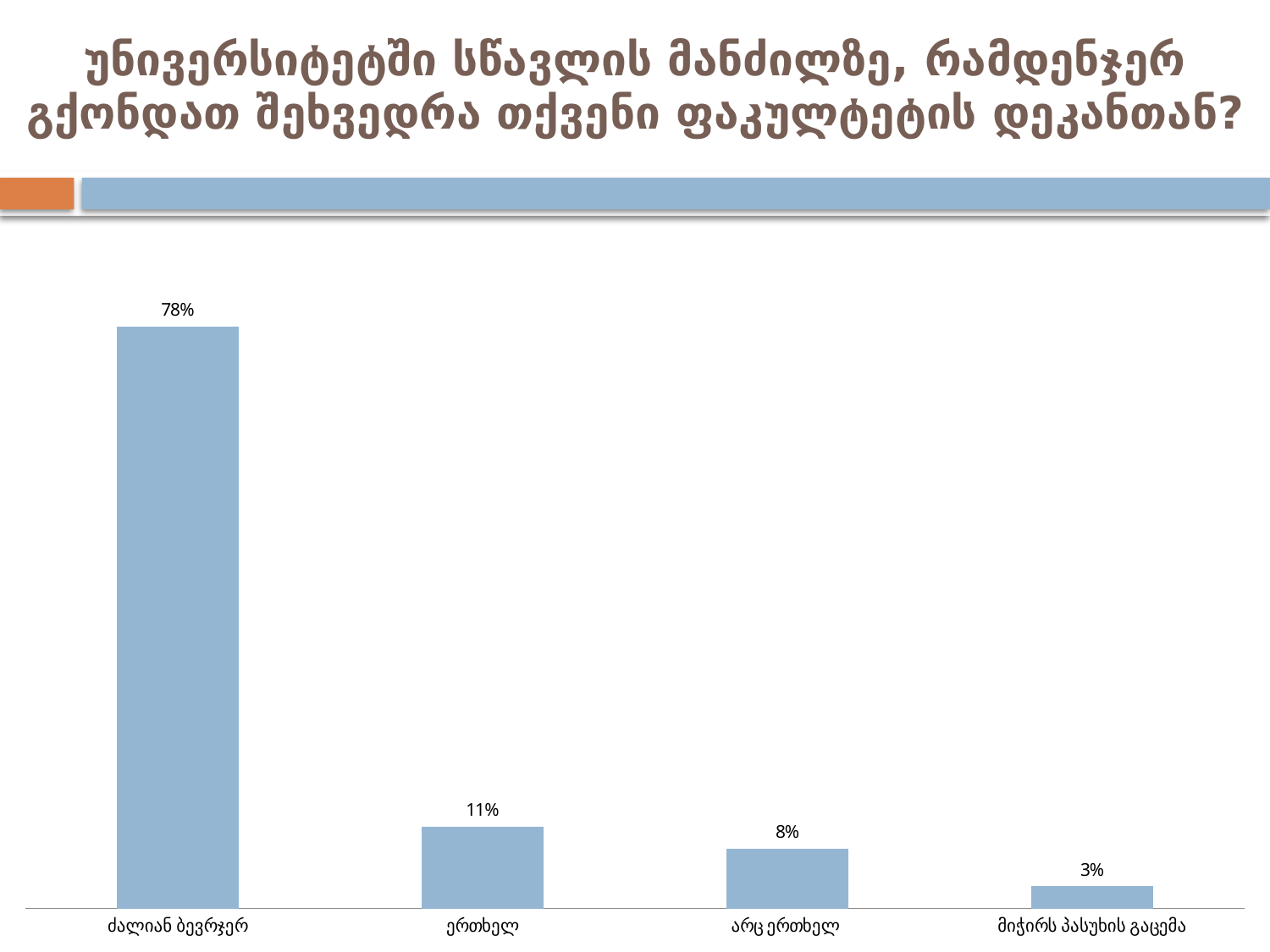
What value is shown for ძალიან ბევრჯერ? 78% What is the difference between the values for ერთხელ and არც ერთხელ? 3% Do the values rise or fall from left to right across the categories? Fall What kind of chart is shown on the slide? Bar chart Which category has the lowest value? მიჭირს პასუხის გაცემა What value is shown for მიჭირს პასუხის გაცემა? 3% How many categories are shown in the chart? 4 What is the difference between the values for ძალიან ბევრჯერ and ერთხელ? 67% What value is shown for არც ერთხელ? 8% Which is larger, the value for არც ერთხელ or the value for მიჭირს პასუხის გაცემა? არც ერთხელ What value is shown for ერთხელ? 11% Which category has the highest value? ძალიან ბევრჯერ